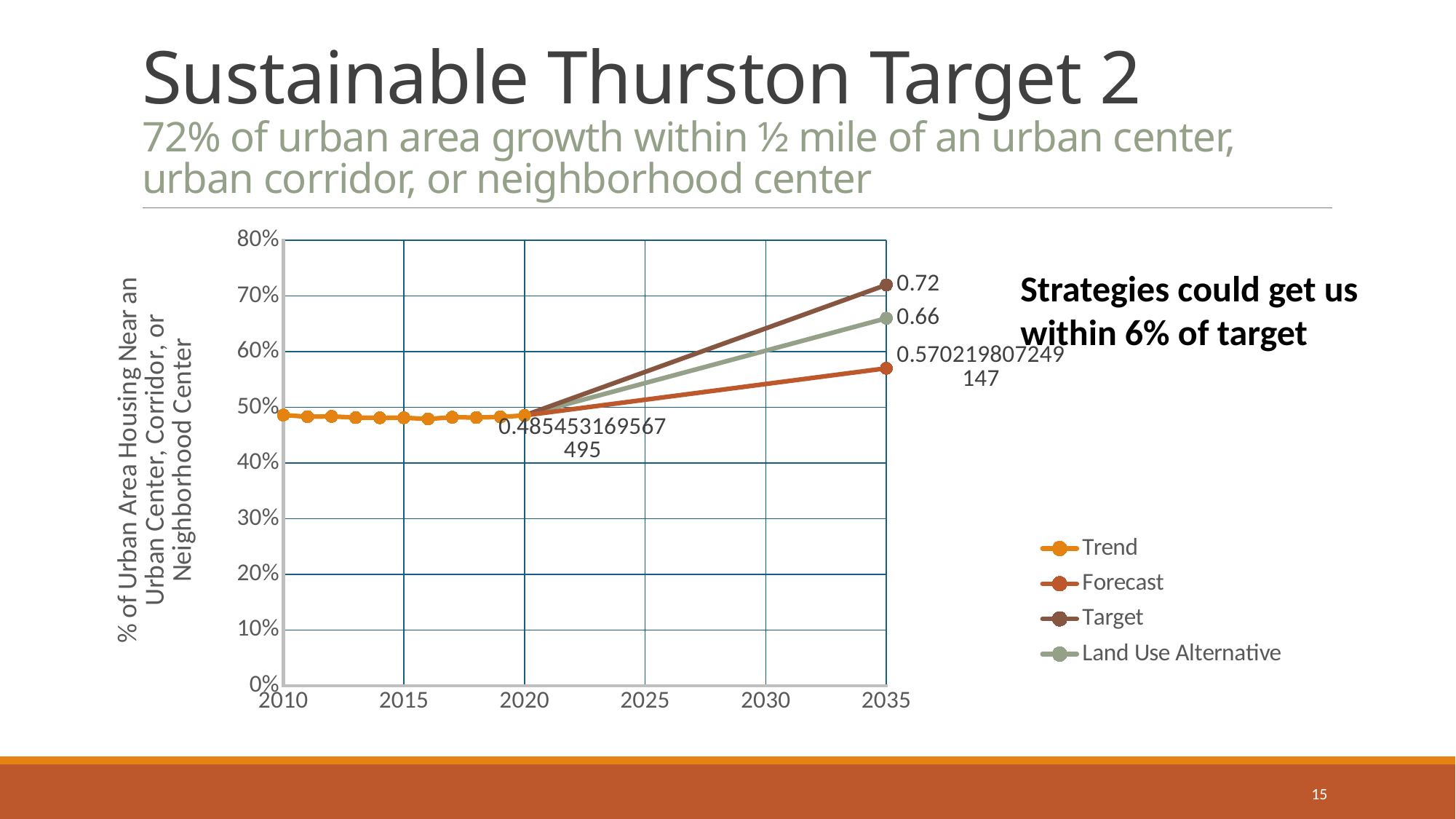
What is the labelled value of the Target series in 2035? 0.72 Which series has the lowest value in 2035? Forecast What is the labelled value of the Forecast series in 2035? 0.570219807249147 How many series does the chart legend list? 4 Which series has the highest value in 2035? Target Does the Target series rise or fall between 2020 and 2035? rise In 2035, which is larger: the Target value or the Land Use Alternative value? Target Is the value of the Trend series in 2010 greater or less than 40%? greater What is the labelled value of the Trend series in 2020? 0.485453169567495 What kind of chart is shown on the slide? line chart What is the labelled value of the Land Use Alternative series in 2035? 0.66 What is the difference between the Target value and the Land Use Alternative value in 2035? 0.06